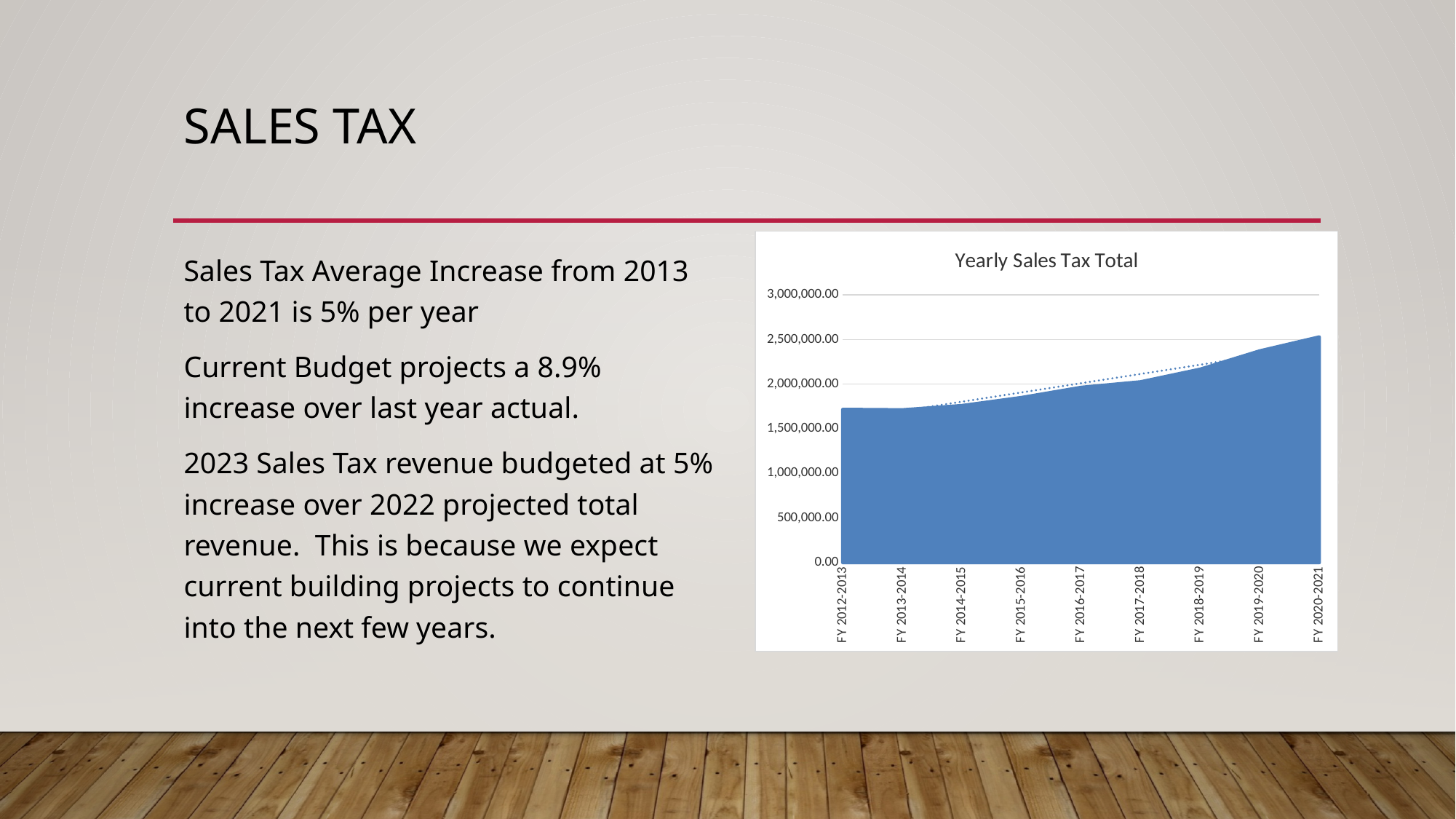
Is the sales tax total for FY 2020-2021 greater or less than 2,000,000.00? greater Is the sales tax total for FY 2012-2013 greater or less than 1,500,000.00? greater What is the highest value shown on the chart's vertical axis? 3,000,000.00 Is the sales tax total for FY 2019-2020 greater or less than 2,500,000.00? less How many fiscal years are plotted on the x axis of the chart? 9 Which is larger, the sales tax total for FY 2020-2021 or for FY 2012-2013? FY 2020-2021 Do the yearly sales tax totals generally rise or fall from FY 2012-2013 to FY 2020-2021? Rise What is the title of the chart? Yearly Sales Tax Total Which fiscal year has the highest yearly sales tax total? FY 2020-2021 What kind of chart is shown on the slide? Area chart